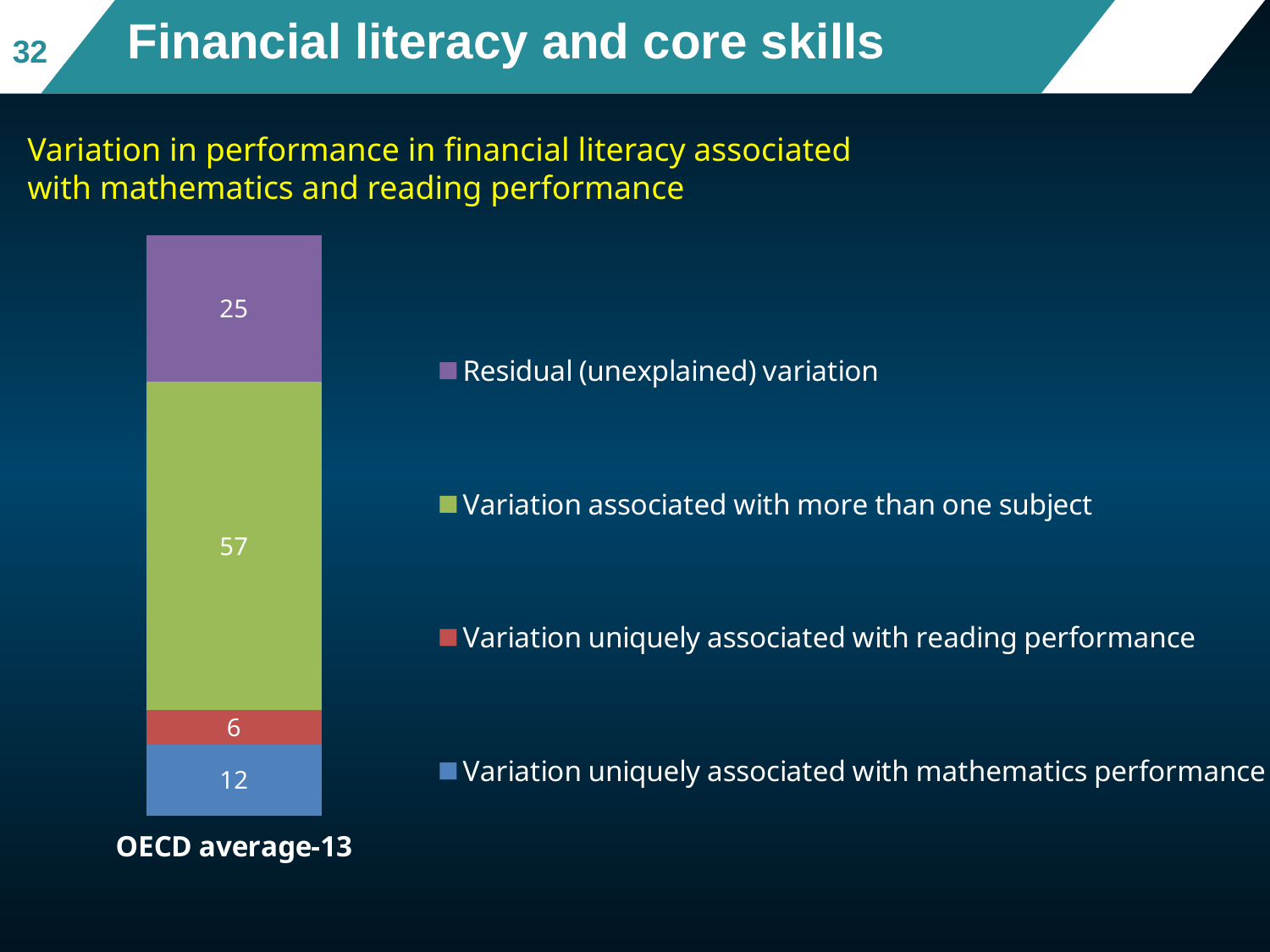
Which series has the largest value in the OECD average-13 bar? Variation associated with more than one subject What is the value for 'Variation uniquely associated with mathematics performance'? 12 What is the category label under the bar? OECD average-13 What kind of chart is shown on the slide? Stacked bar chart Which series has the smallest value in the OECD average-13 bar? Variation uniquely associated with reading performance How many series does the legend list? 4 What is the value for 'Variation associated with more than one subject' in the OECD average-13 bar? 57 What is the value for 'Variation uniquely associated with reading performance'? 6 Which is larger: the value for variation uniquely associated with mathematics performance or with reading performance? Variation uniquely associated with mathematics performance What is the difference between the value for 'Variation associated with more than one subject' and 'Residual (unexplained) variation'? 32 What is the total of the OECD average-13 stacked bar? 100 What is the value for 'Residual (unexplained) variation' in the OECD average-13 bar? 25